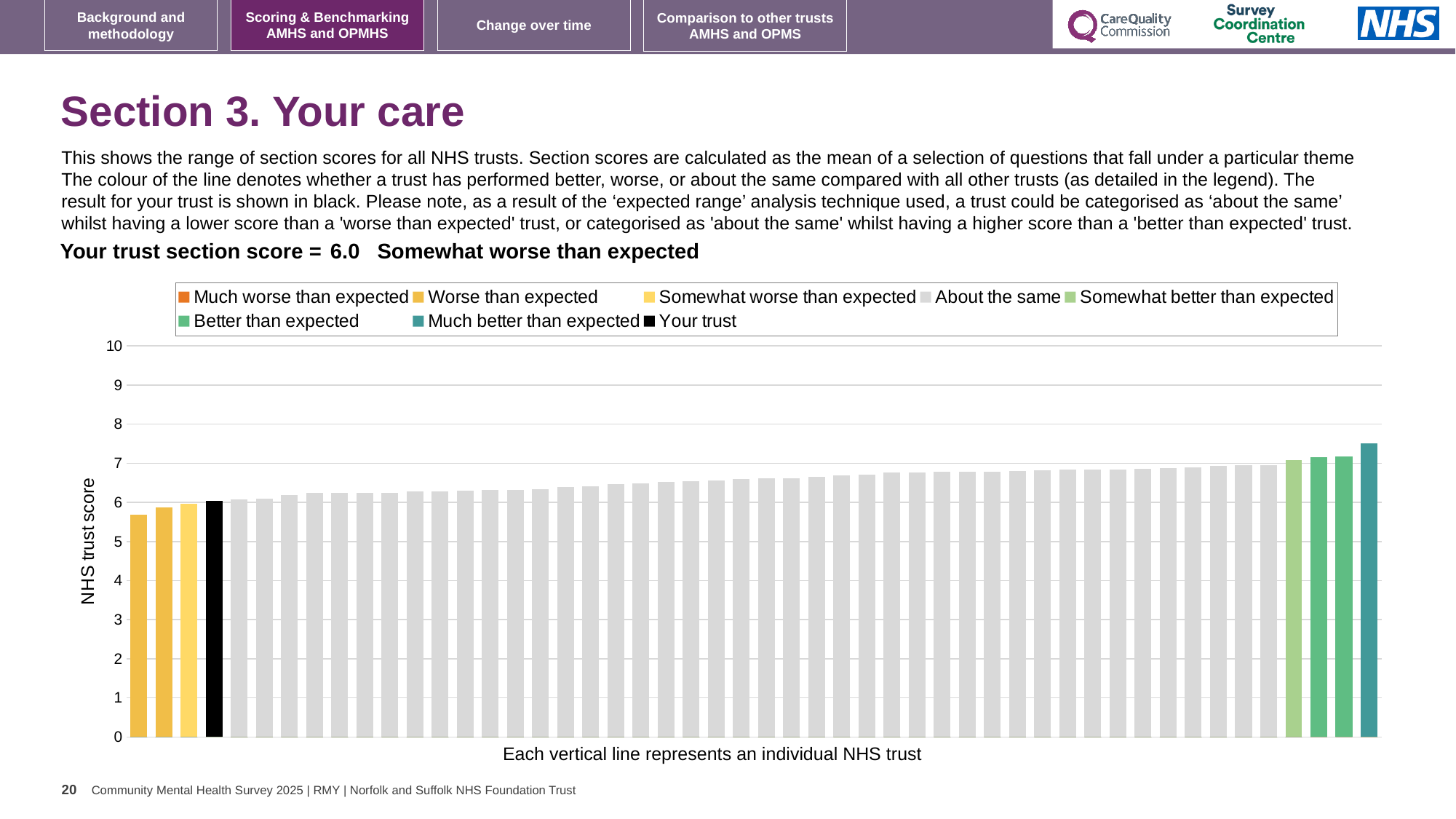
Is the value of the tallest bar greater or less than 7? greater Is your trust's section score greater or less than 7? less Do the bar values rise or fall from left to right along the x axis? rise What is the label on the y axis of the chart? NHS trust score How many bars are coloured as 'Worse than expected'? 2 Which performance category is your trust's section score labelled as? Somewhat worse than expected What is the section score for your trust shown on the slide? 6.0 What kind of chart is shown on the slide? bar chart Is the value of the shortest bar greater or less than 6? less Which legend category does the tallest bar belong to? Much better than expected How many entries does the chart legend list? 8 What colour is the bar representing your trust? black